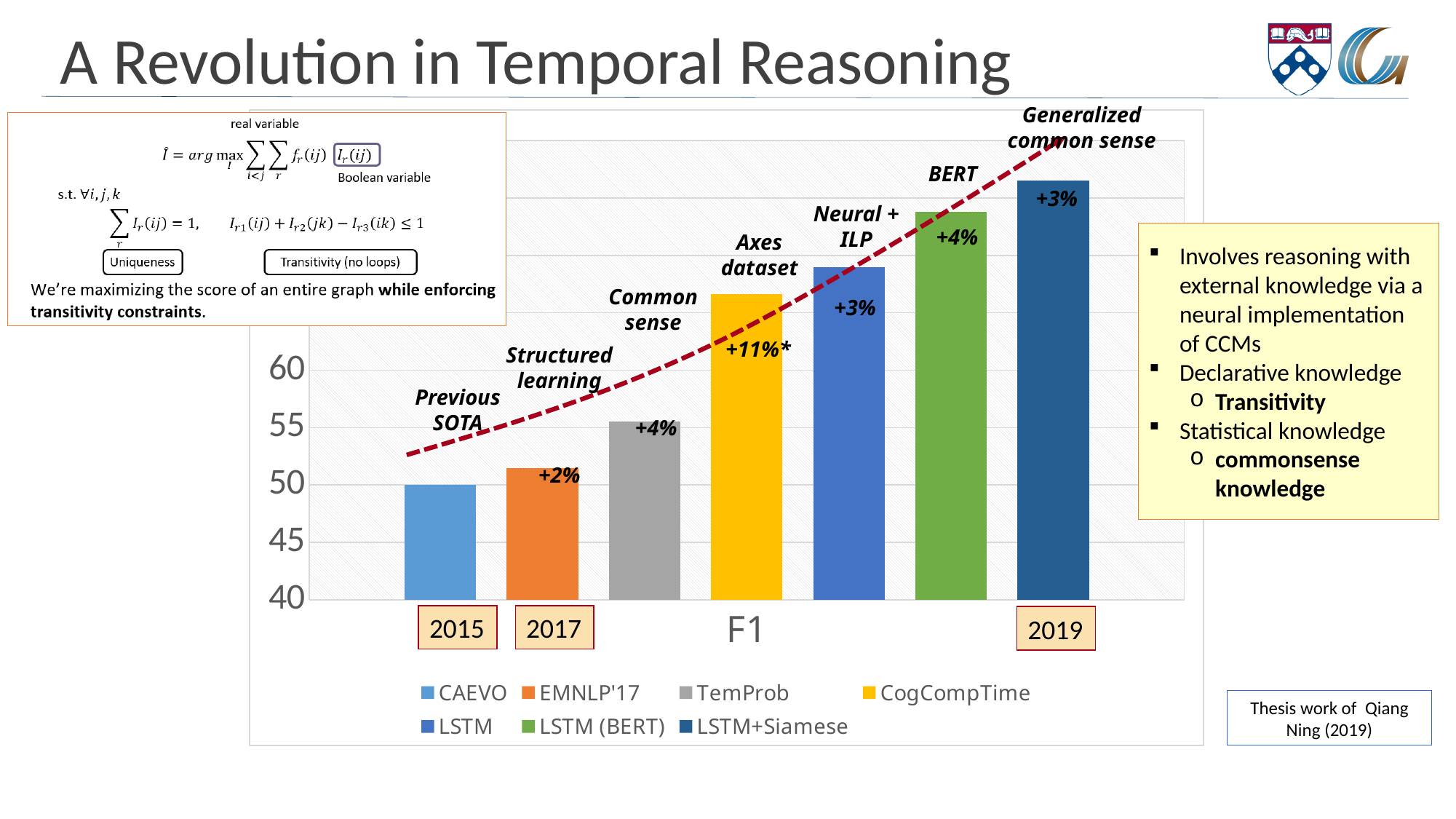
Which is larger, the F1 bar for TemProb or the F1 bar for EMNLP'17? TemProb What improvement label is printed on the CogCompTime bar? +11%* Do the bars rise or fall from left to right across the chart? rise How many series does the chart legend list? 7 Is the F1 value for TemProb greater or less than 60? less Which series has the lowest F1 bar? CAEVO Is the F1 value for EMNLP'17 greater or less than 55? less What is the category label shown on the x axis of the chart? F1 Which is larger, the F1 bar for LSTM (BERT) or the F1 bar for CogCompTime? LSTM (BERT) Is the F1 value for CogCompTime greater or less than 60? greater What kind of chart is shown on the slide? bar chart Which series has the highest F1 bar? LSTM+Siamese